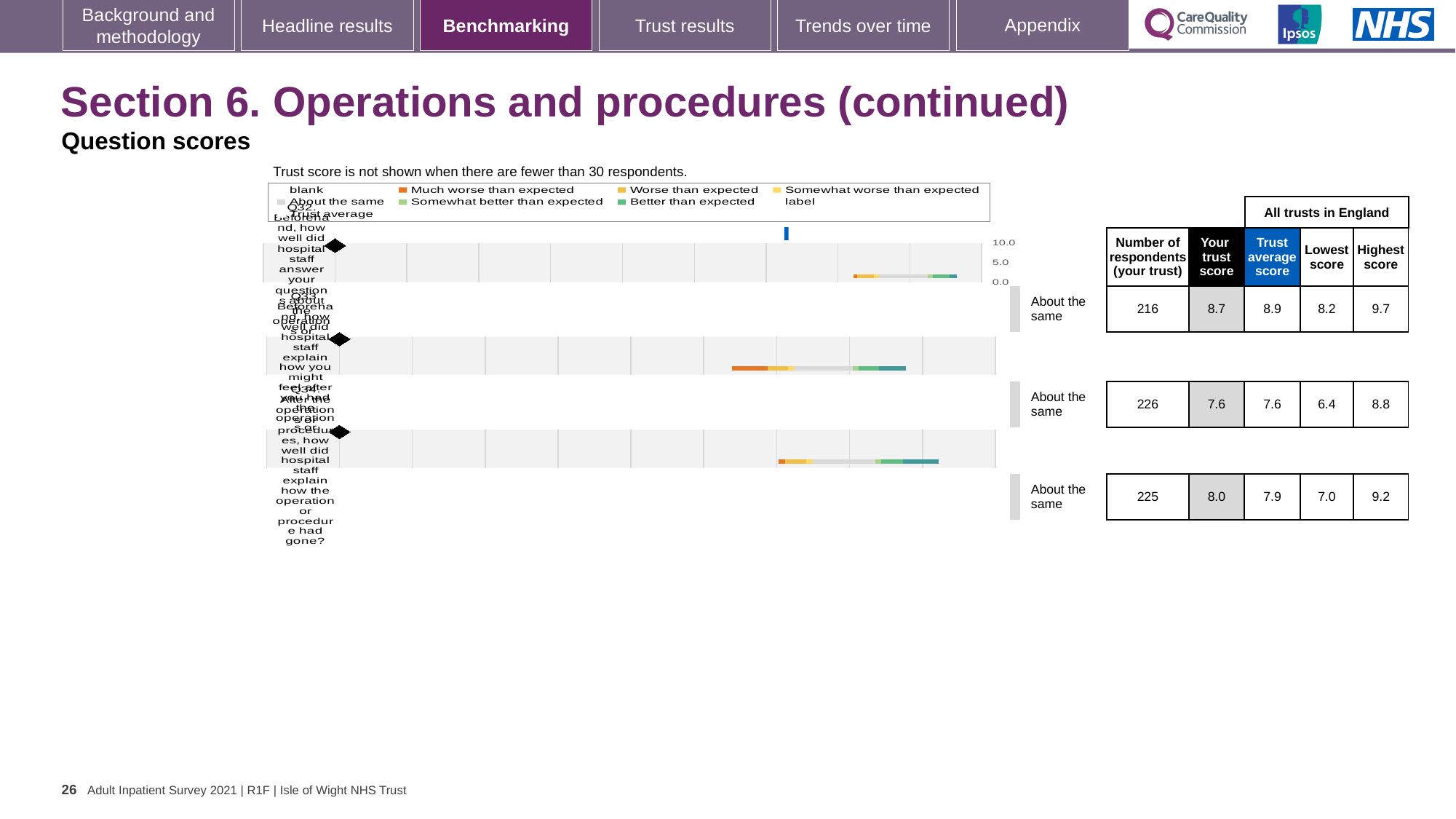
What is the 'Your trust score' for the first row, which has 216 respondents? 8.7 What kind of chart is used to show the question scores on this slide? bar chart What is the difference between the highest score and the lowest score for the first row (216 respondents)? 1.5 Which row has the highest 'Your trust score'? The first row (216 respondents), 8.7 What benchmark category is shown next to each of the three rows? About the same How many question rows are plotted in the chart? 3 What is the 'Highest score' for the third row, which has 225 respondents? 9.2 For the third row (225 respondents), which is larger: 'Your trust score' or 'Trust average score'? Your trust score (8.0) What is the maximum value shown on the chart's score axis? 10.0 What is the 'Lowest score' for the first row, which has 216 respondents? 8.2 Which row has the lowest 'Lowest score' across all trusts in England? The second row (226 respondents), 6.4 What is the 'Trust average score' for the row with 226 respondents? 7.6